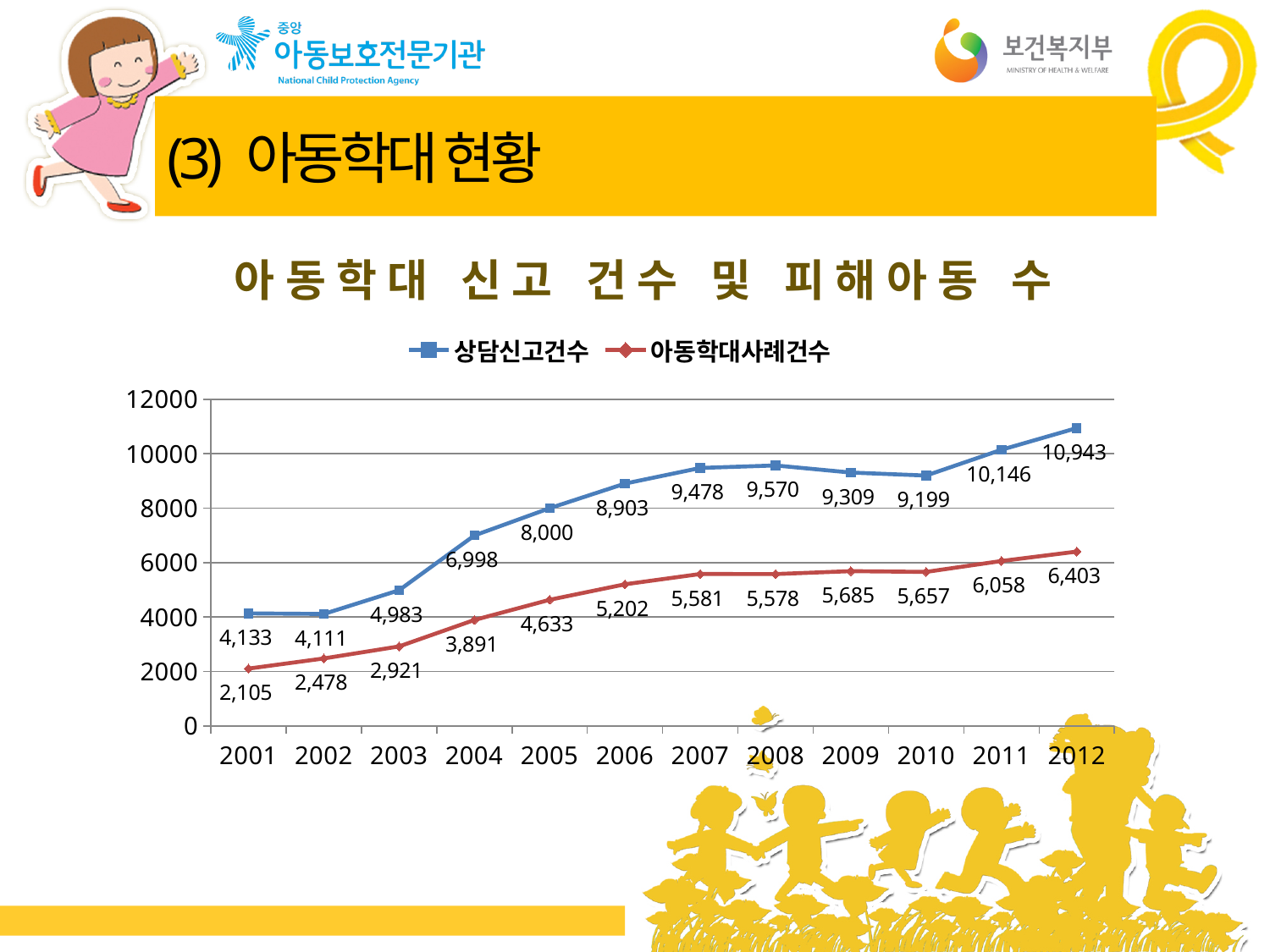
In which year is 아동학대사례건수 the lowest? 2001 What is the value of 아동학대사례건수 in 2004? 3,891 What is the difference between 상담신고건수 and 아동학대사례건수 in 2012? 4,540 In which year is 상담신고건수 the highest? 2012 What kind of chart is shown on the slide? line chart How many series does the legend list? 2 Which is larger, 상담신고건수 in 2005 or 상담신고건수 in 2006? 2006 What is the title of the chart? 아동학대 신고 건수 및 피해아동 수 How many years are shown on the x axis? 12 What is the value of 상담신고건수 in 2012? 10,943 What is the value of 상담신고건수 in 2008? 9,570 Does 아동학대사례건수 generally rise or fall from 2001 to 2012? rise